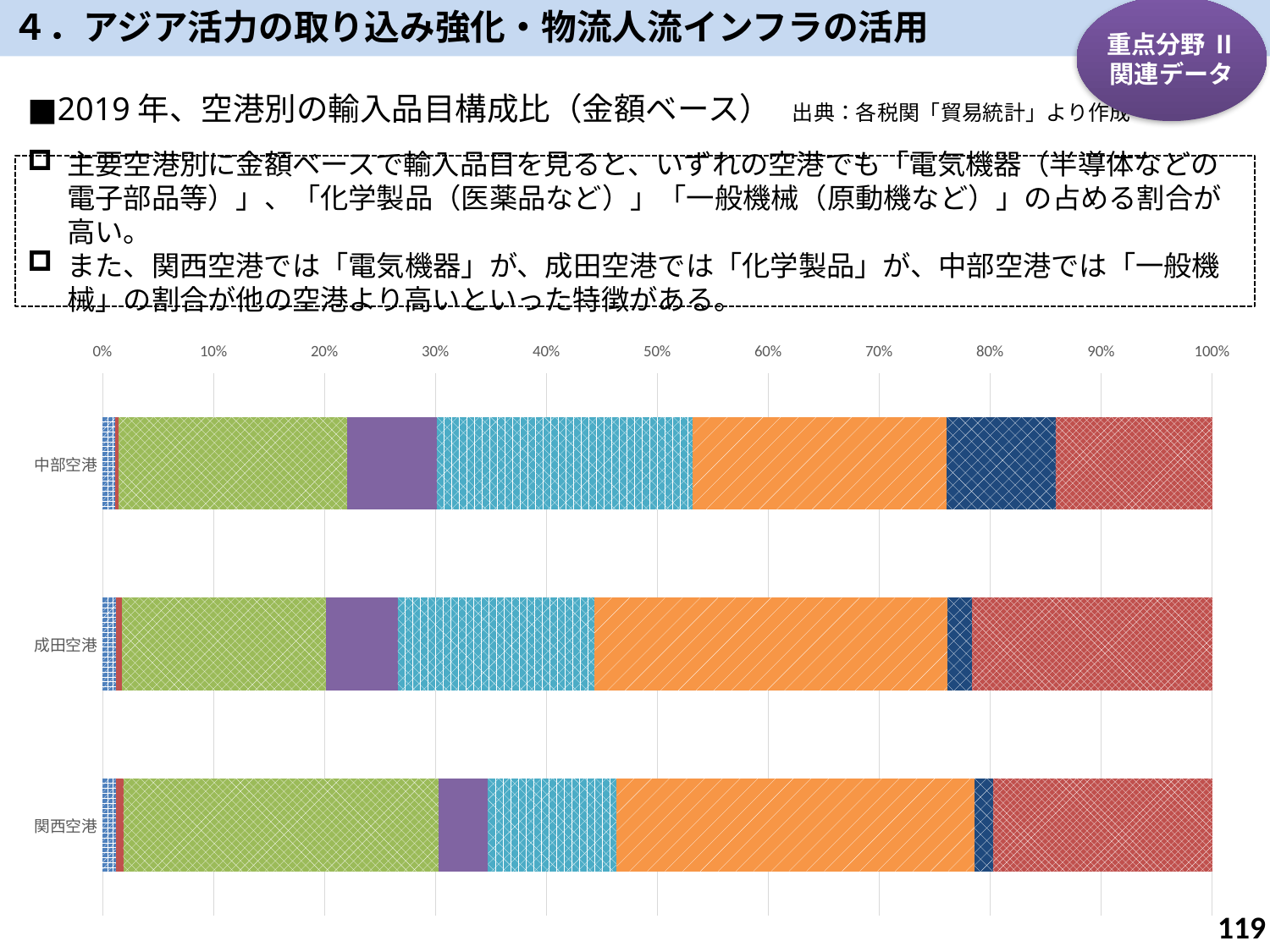
Is the green (first large) segment for 中部空港 greater or less than 30%? less Which airport has the larger light-blue hatched segment, 中部空港 or 関西空港? 中部空港 What kind of chart is shown on the slide? stacked bar chart What is the title of the chart on the slide? 2019年、空港別の輸入品目構成比（金額ベース） Which airport has the largest light-blue hatched segment in the chart? 中部空港 Does the orange segment for 成田空港 end at a point greater or less than 70% on the axis? greater Is the green (first large) segment for 関西空港 greater or less than 20%? greater How many airports are shown as categories in the chart? 3 Which airport has the larger green segment, 関西空港 or 成田空港? 関西空港 Which airport has the larger dark-blue segment, 中部空港 or 成田空港? 中部空港 Which airport has the largest green segment in the chart? 関西空港 What is the highest value shown on the percentage axis of the chart? 100%